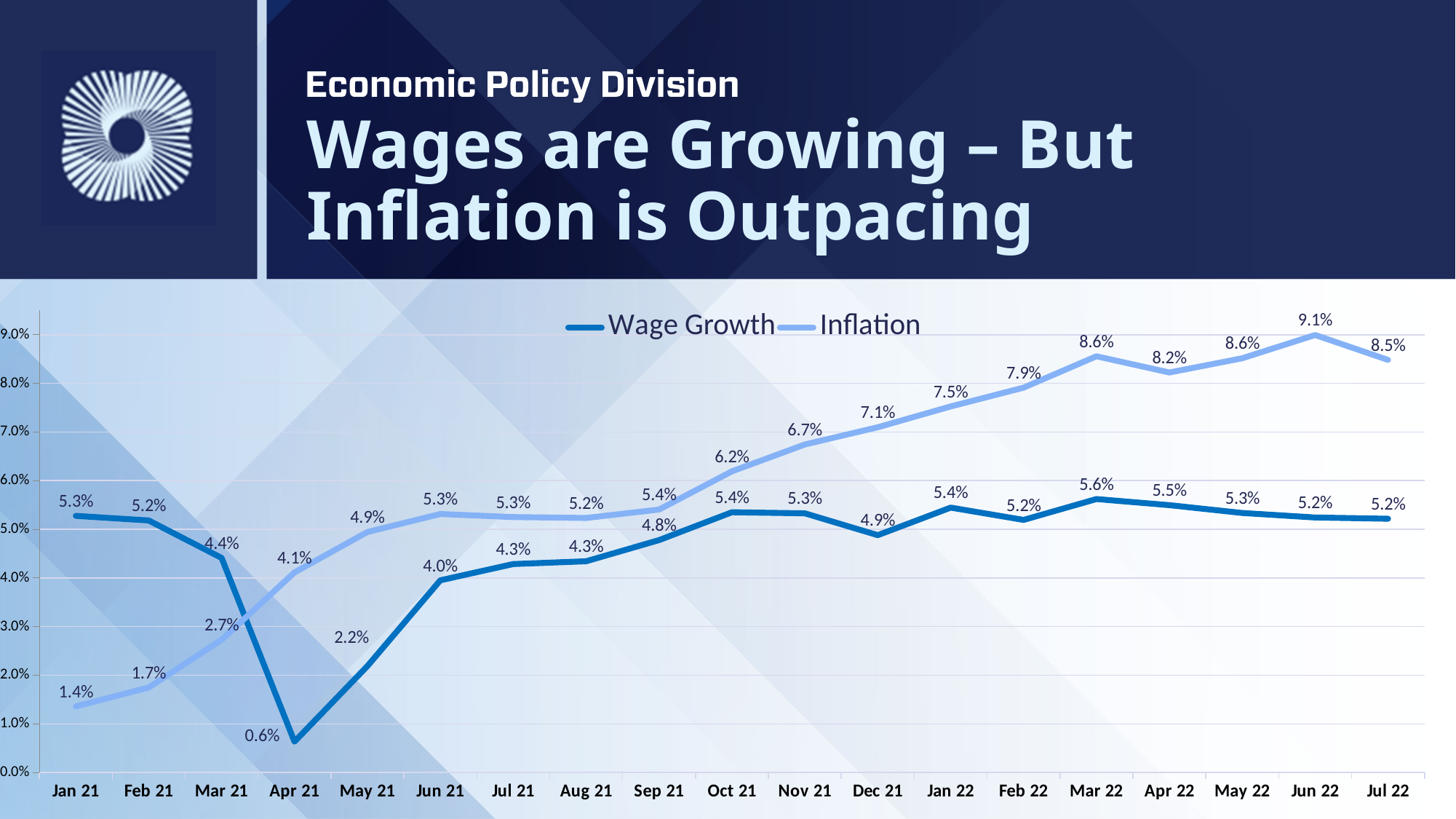
In which month is Wage Growth at its lowest? Apr 21 In which month does Inflation reach its highest value? Jun 22 What is the Wage Growth value for Jul 22? 5.2% What is the Inflation value for Jan 21? 1.4% What kind of chart is shown on the slide? Line chart How many series does the legend list? 2 What is the Inflation value for Jun 22? 9.1% By how many percentage points does Inflation exceed Wage Growth in Jul 22? 3.3 percentage points What is the Wage Growth value for Apr 21? 0.6% Which is larger in Jan 21, Wage Growth or Inflation? Wage Growth How many months are plotted on the x axis? 19 In which month does Wage Growth reach its highest value? Mar 22